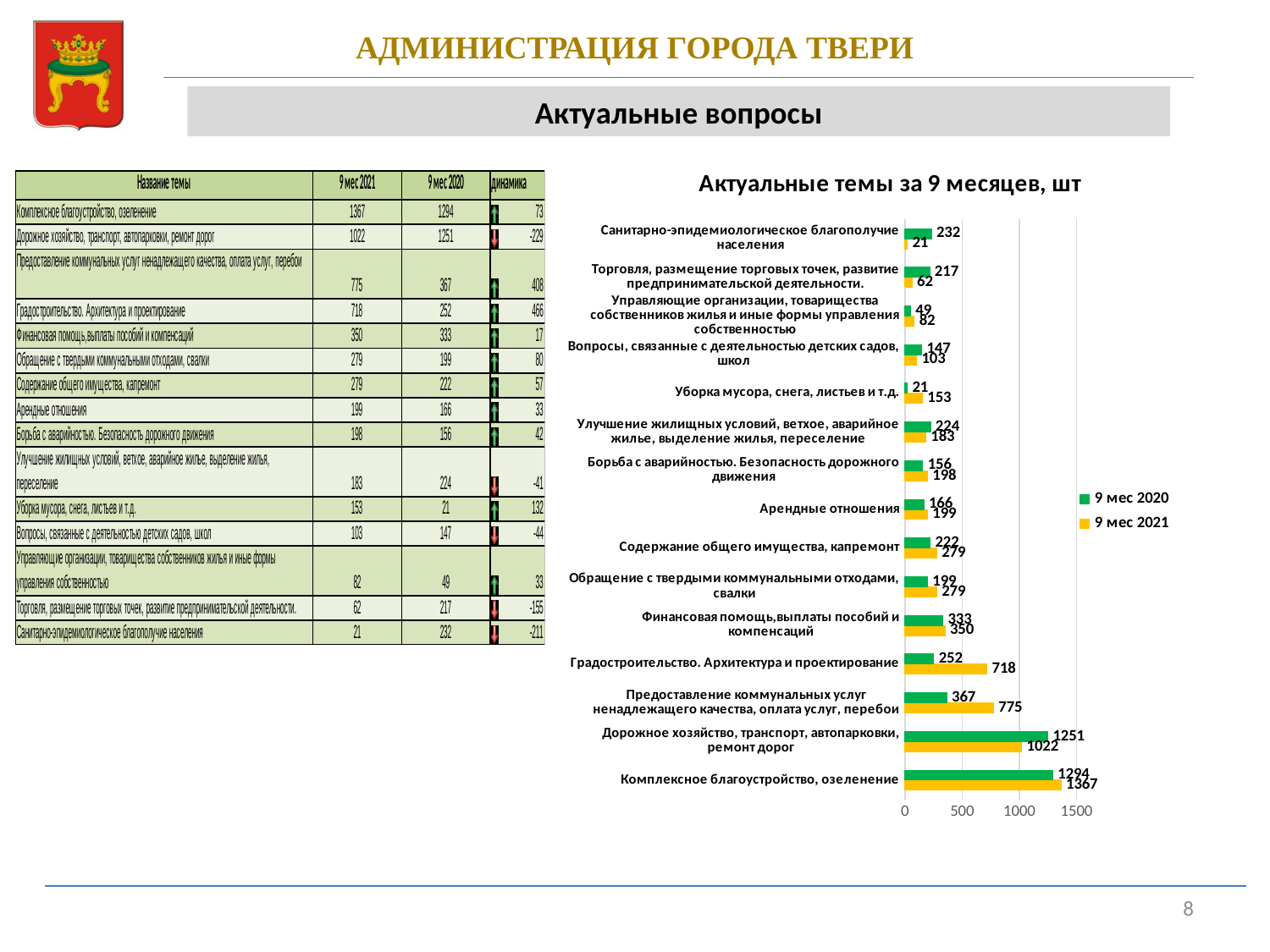
For 'Торговля, размещение торговых точек, развитие предпринимательской деятельности', which series has the larger value: '9 мес 2020' or '9 мес 2021'? 9 мес 2020 What is the difference between the '9 мес 2021' and '9 мес 2020' values for 'Градостроительство. Архитектура и проектирование'? 466 What is the title of the chart? Актуальные темы за 9 месяцев, шт Is the '9 мес 2021' value for 'Предоставление коммунальных услуг ненадлежащего качества, оплата услуг, перебои' greater or less than 500? greater How many series does the legend of the chart list? 2 Which category has the lowest value in the '9 мес 2021' series? Санитарно-эпидемиологическое благополучие населения Which category has the highest value in the '9 мес 2021' series? Комплексное благоустройство, озеленение How many categories are plotted in the chart? 15 What is the value for 'Дорожное хозяйство, транспорт, автопарковки, ремонт дорог' in the '9 мес 2020' series? 1251 What is the value for 'Комплексное благоустройство, озеленение' in the '9 мес 2021' series? 1367 What is the value for 'Уборка мусора, снега, листьев и т.д.' in the '9 мес 2021' series? 153 What type of chart is shown on the slide? bar chart